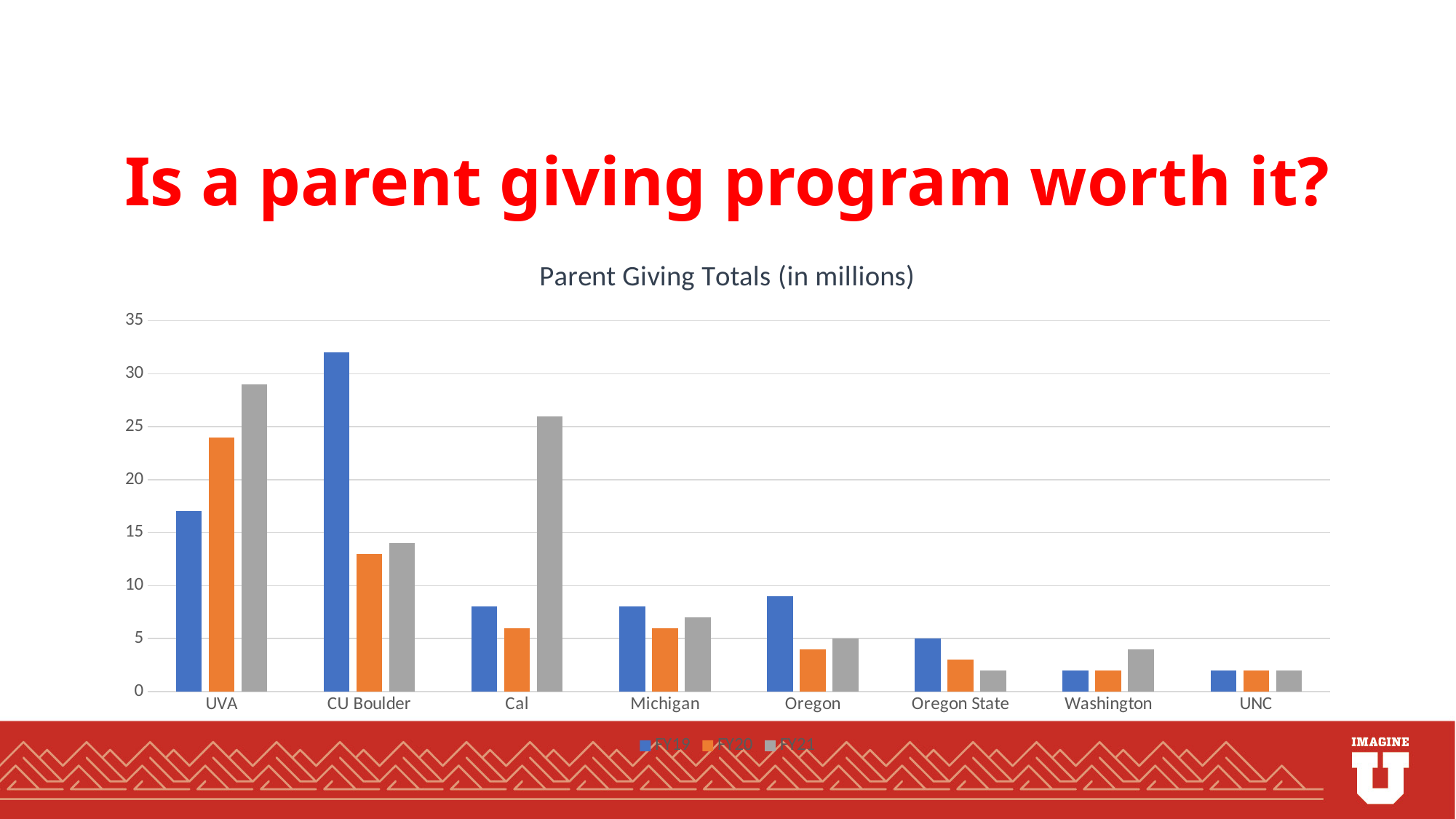
Is the FY19 value for Michigan greater or less than 10? less Which university has the highest FY19 value? CU Boulder Which is larger, the FY20 value for UVA or the FY20 value for CU Boulder? UVA Is the FY21 value for Cal greater or less than 20? greater Is the FY19 value for CU Boulder greater or less than 30? greater What kind of chart is shown on the slide? bar chart Do UVA's values rise or fall from FY19 to FY21? rise Which university has the highest FY21 value? UVA What is the title of the chart? Parent Giving Totals (in millions) How many series does the chart's legend list? 3 How many universities are shown on the x axis of the chart? 8